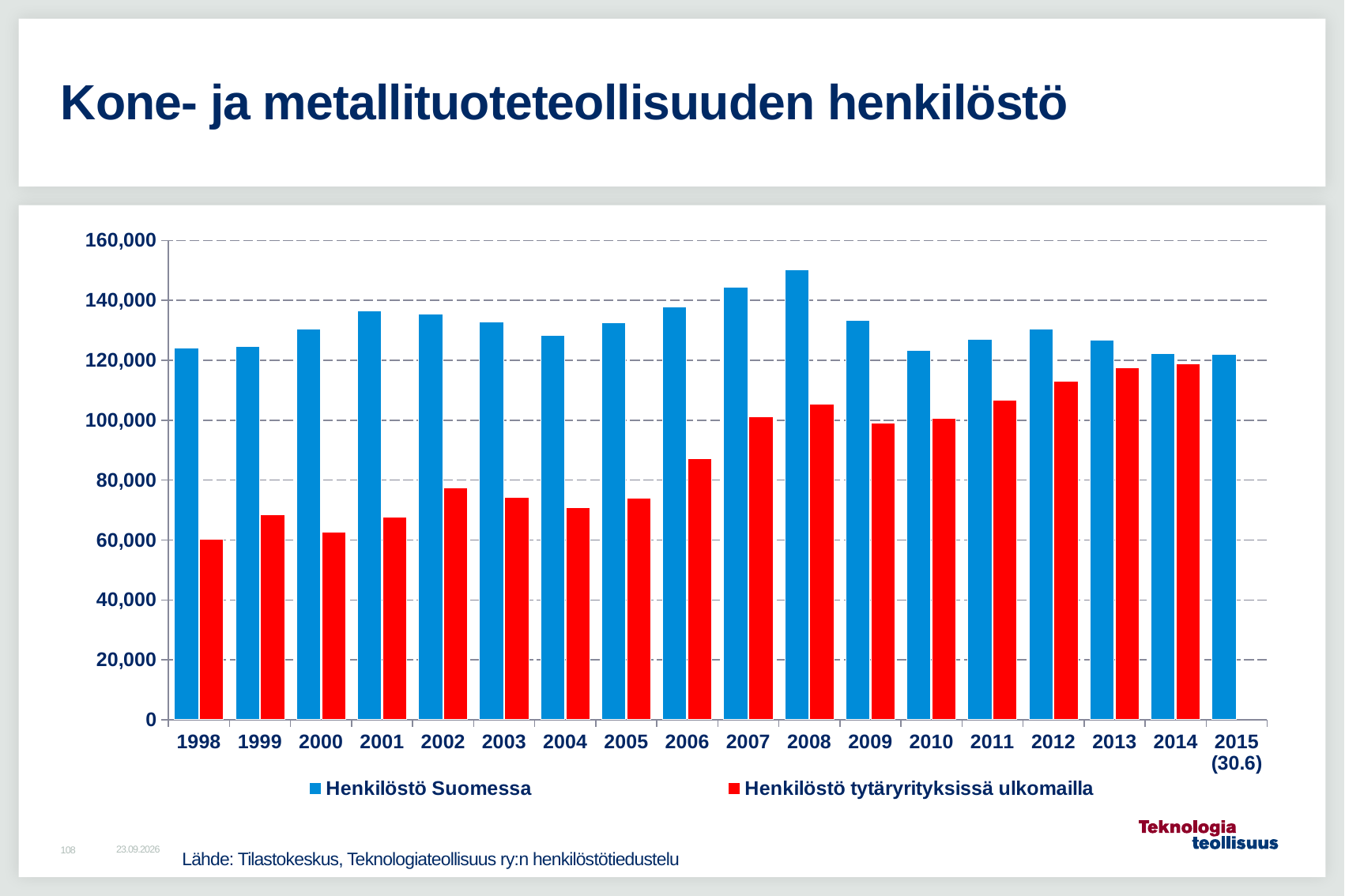
Does the value for Henkilöstö tytäryrityksissä ulkomailla generally rise or fall from 1998 to 2014? rise How many series does the legend list? 2 What colour are the bars for Henkilöstö tytäryrityksissä ulkomailla? red Which is larger in 2008: Henkilöstö Suomessa or Henkilöstö tytäryrityksissä ulkomailla? Henkilöstö Suomessa How many years are shown on the x axis? 18 What kind of chart is shown on the slide? bar chart Is the value for Henkilöstö Suomessa in 2008 greater or less than 140,000? greater Is the value for Henkilöstö tytäryrityksissä ulkomailla in 2008 greater or less than 100,000? greater Is the value for Henkilöstö tytäryrityksissä ulkomailla in 1998 greater or less than 80,000? less In which year is the value for Henkilöstö tytäryrityksissä ulkomailla lowest? 1998 In which year is the value for Henkilöstö Suomessa highest? 2008